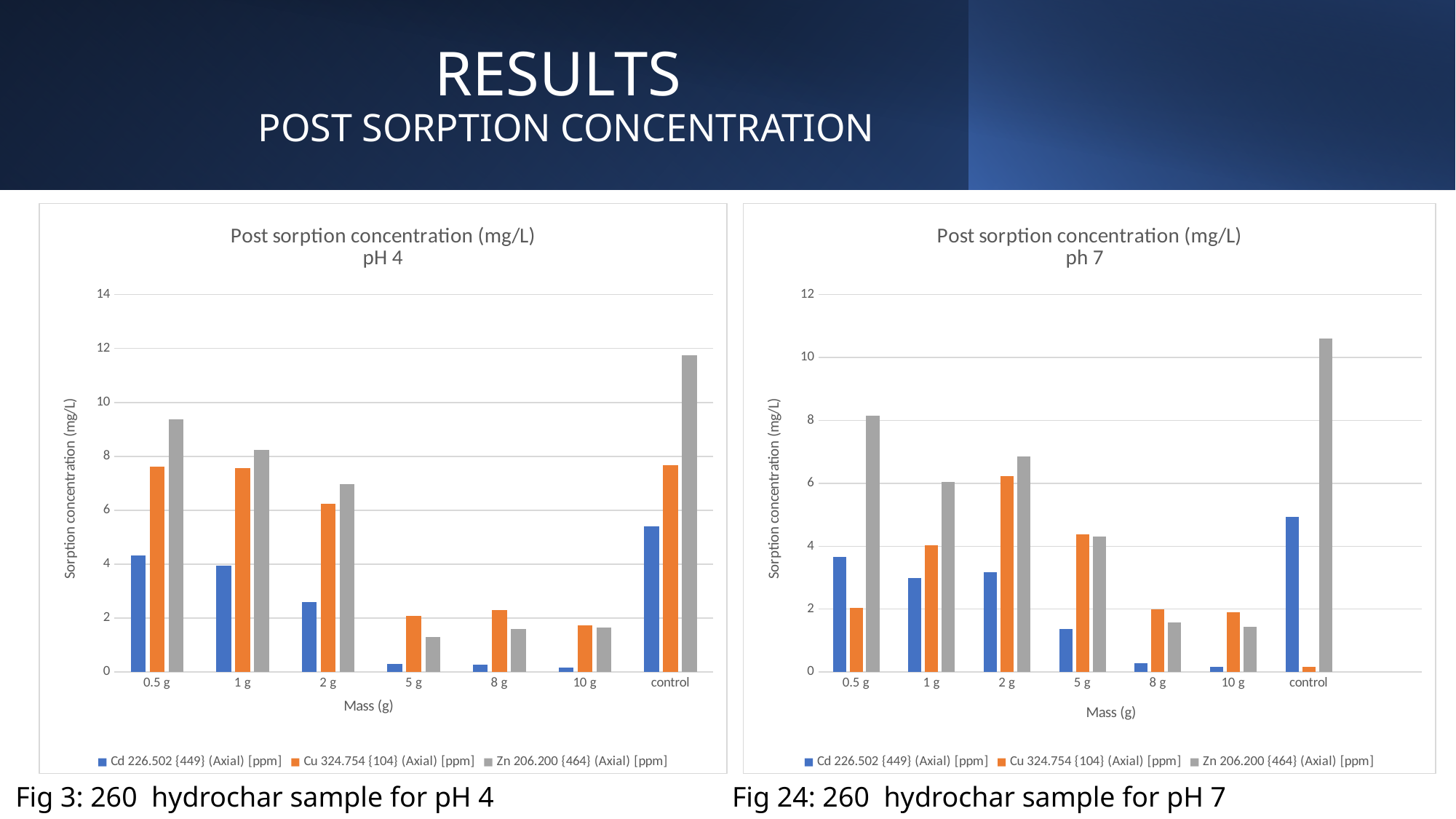
How many mass categories are shown on the x axis of the 'Post sorption concentration (mg/L) ph 7' chart? 7 How many series does the legend of the 'Post sorption concentration (mg/L) pH 4' chart list? 3 In the 'Post sorption concentration (mg/L) ph 7' chart, is the Cd 226.502 {449} (Axial) [ppm] value for 0.5 g greater or less than 4? less In the 'Post sorption concentration (mg/L) ph 7' chart, is the Zn 206.200 {464} (Axial) [ppm] value for control greater or less than 10? greater In the 'Post sorption concentration (mg/L) pH 4' chart, which category has the highest Zn 206.200 {464} (Axial) [ppm] bar? control In the 'Post sorption concentration (mg/L) ph 7' chart, which is larger at 1 g: the Cu 324.754 {104} (Axial) [ppm] bar or the Zn 206.200 {464} (Axial) [ppm] bar? Zn 206.200 {464} (Axial) [ppm] In the 'Post sorption concentration (mg/L) pH 4' chart, is the Cd 226.502 {449} (Axial) [ppm] value for control greater or less than 4? greater In the 'Post sorption concentration (mg/L) pH 4' chart, does the Cd 226.502 {449} (Axial) [ppm] series rise or fall from 0.5 g to 10 g? fall What is the x-axis title of the 'Post sorption concentration (mg/L) ph 7' chart? Mass (g) In the 'Post sorption concentration (mg/L) pH 4' chart, which is larger at 0.5 g: the Cu 324.754 {104} (Axial) [ppm] bar or the Zn 206.200 {464} (Axial) [ppm] bar? Zn 206.200 {464} (Axial) [ppm] What type of chart is the 'Post sorption concentration (mg/L) pH 4' chart? bar chart